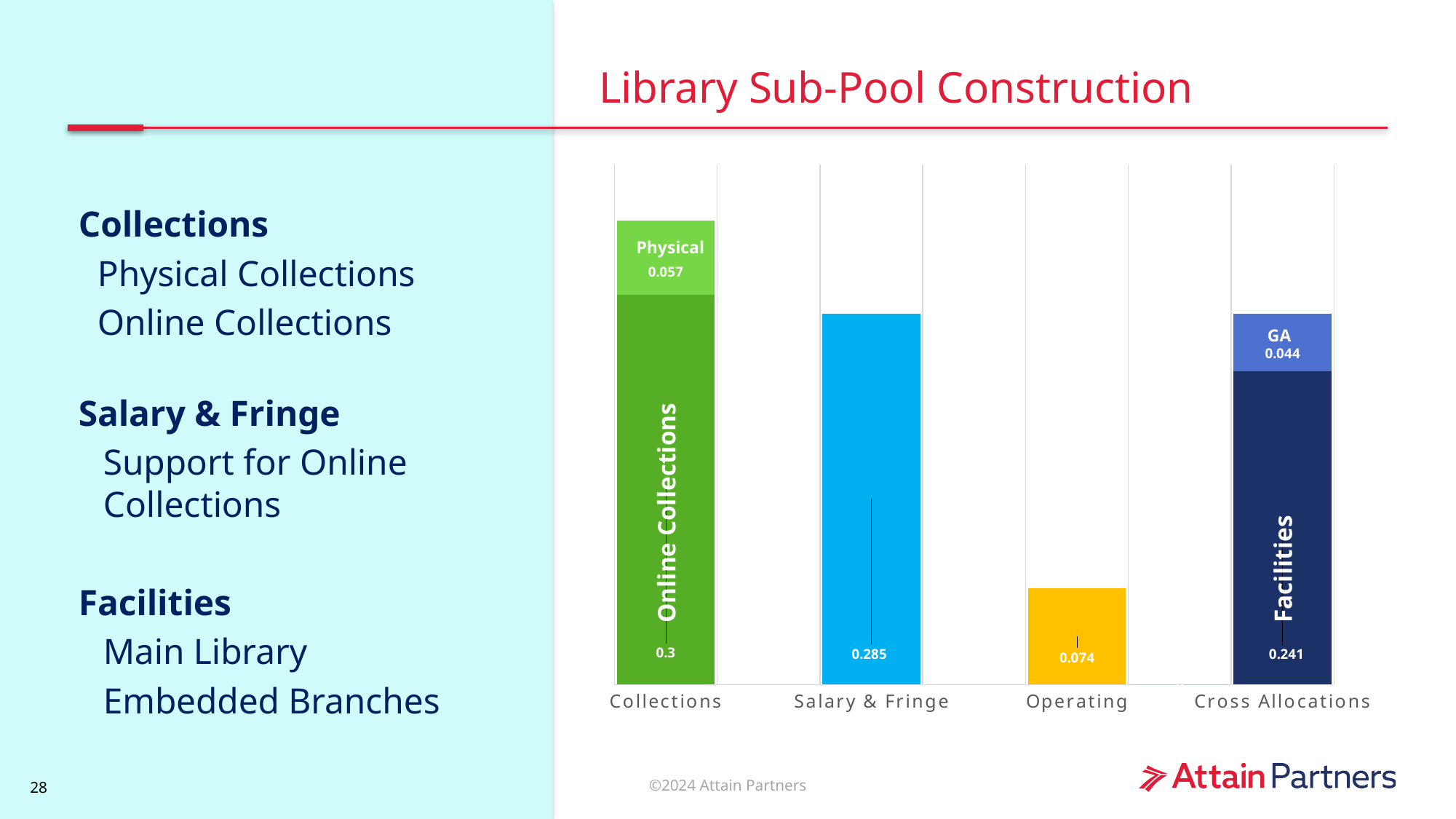
How many categories are shown on the x axis? 4 Which category has the tallest bar overall? Collections Which category has the lowest value? Operating What is the value shown for Operating? 0.074 What is the total of the Collections stacked bar? 0.357 What is the difference between the Facilities segment and the Operating value? 0.167 What is the value shown for Salary & Fringe? 0.285 What is the value of the Facilities segment in the Cross Allocations bar? 0.241 What is the value of the Online Collections segment in the Collections bar? 0.3 What is the value of the Physical segment in the Collections bar? 0.057 What is the total of the Cross Allocations stacked bar? 0.285 What is the value of the GA segment in the Cross Allocations bar? 0.044